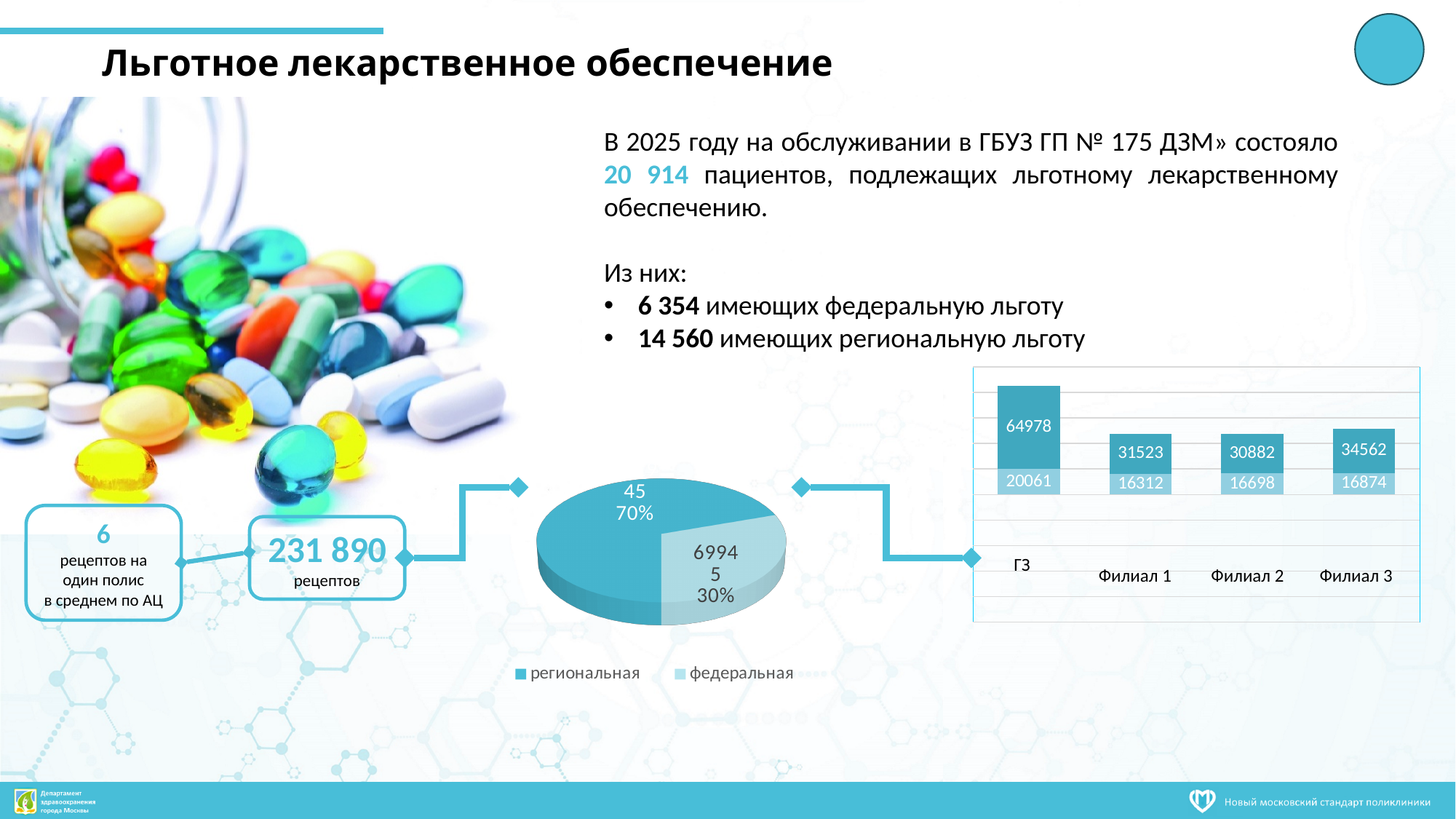
In the bar chart on the right, which category has the lowest value in the lower (lighter) segment? Филиал 1 In the bar chart on the right, what is the difference between the upper segment values of ГЗ and Филиал 1? 33455 In the bar chart on the right, which category has the highest value in the upper (darker) segment? ГЗ How many entries does the legend of the pie chart list? 2 In the bar chart on the right, what is the value of the lower (lighter) segment for Филиал 2? 16698 What kind of chart is the chart on the right of the slide with categories ГЗ, Филиал 1, Филиал 2 and Филиал 3? bar chart In the bar chart on the right, how many categories are shown on the x axis? 4 In the bar chart on the right, what is the value of the upper (darker) segment for ГЗ? 64978 In the bar chart on the right, what is the total of the stacked bar for Филиал 3? 51436 In the pie chart, what share does the 'федеральная' slice represent? 30% In the pie chart, what share does the 'региональная' slice represent? 70% What kind of chart is the chart in the centre of the slide with the 'региональная' and 'федеральная' legend? pie chart